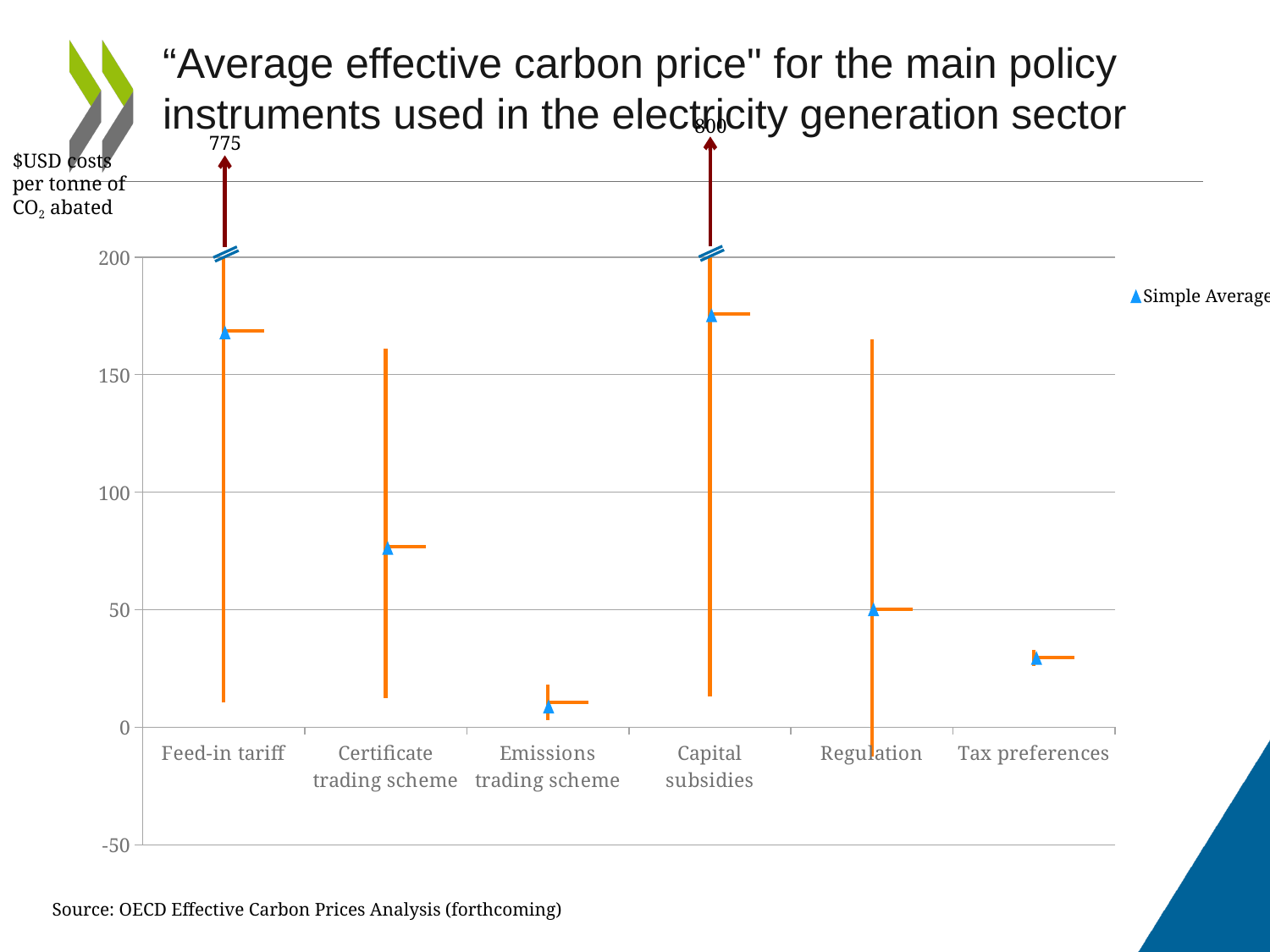
Is the Simple Average value for Feed-in tariff greater or less than 150? greater Which policy instrument has the lowest Simple Average marker? Emissions trading scheme What unit is given for the y axis? $USD costs per tonne of CO2 abated What is the upper value printed above the Feed-in tariff range? 775 What is the difference between the printed upper values for Capital subsidies and Feed-in tariff? 25 What is the upper value printed above the Capital subsidies range? 800 Is the Simple Average value for Tax preferences greater or less than 50? less Is the Simple Average value for Emissions trading scheme greater or less than 50? less How many series does the legend list? 1 How many policy instruments are shown on the x axis? 6 Which policy instrument has the higher printed upper value, Feed-in tariff or Capital subsidies? Capital subsidies